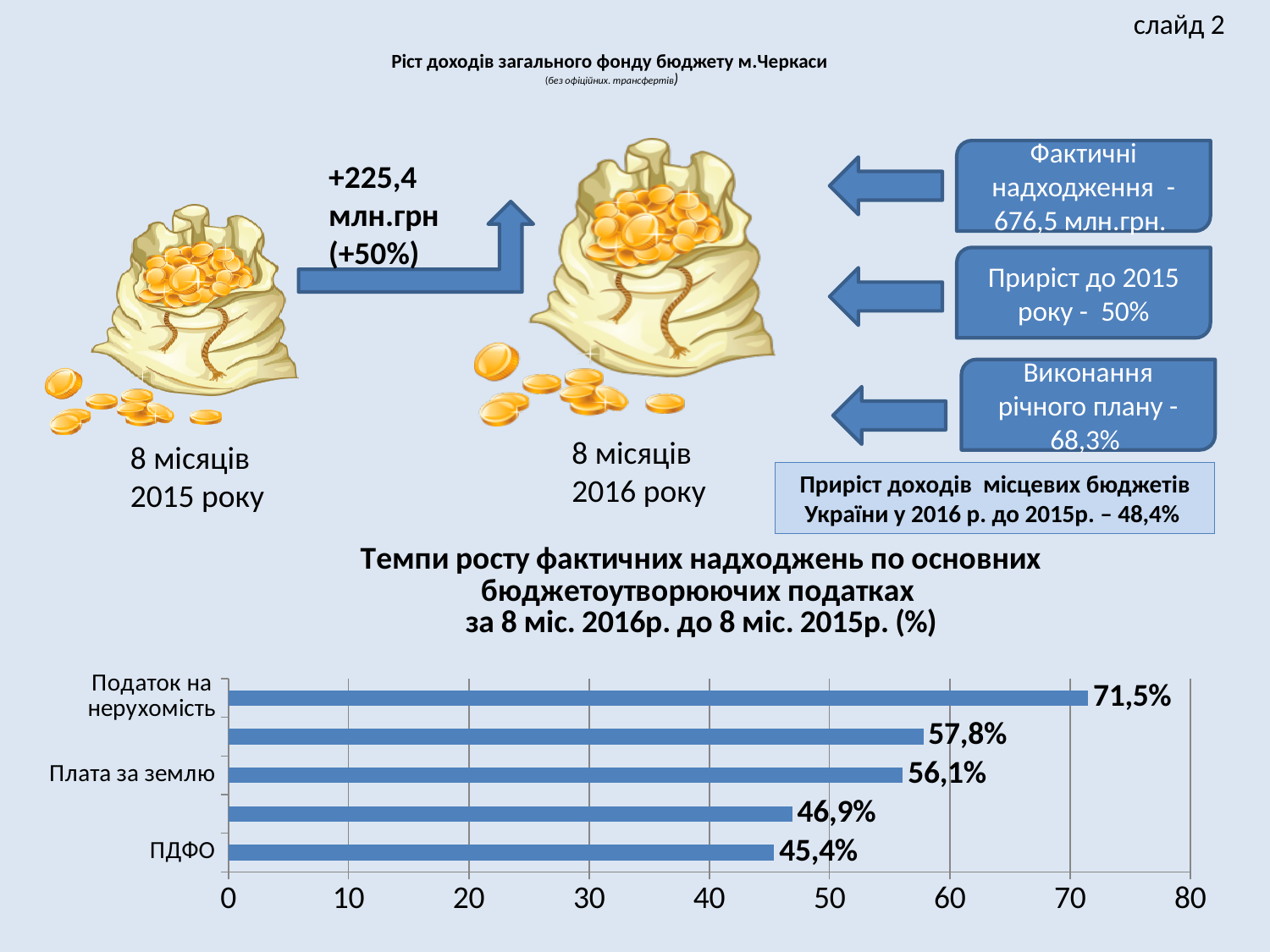
What is the value for Плата за землю in the bar chart? 56,1% Which category has the lowest value in the bar chart? ПДФО Is the value for Податок на нерухомість greater or less than 70? greater By how many percentage points does Податок на нерухомість exceed ПДФО in the bar chart? 26,1 How many bars are plotted in the bar chart? 5 What is the maximum value shown on the horizontal axis of the bar chart? 80 What is the value for Податок на нерухомість in the bar chart? 71,5% Which is larger in the bar chart: Плата за землю or ПДФО? Плата за землю What is the value for ПДФО in the bar chart? 45,4% Which category has the highest value in the bar chart? Податок на нерухомість What is the difference between the values for Плата за землю and ПДФО in the bar chart? 10,7 What kind of chart is shown at the bottom of the slide? bar chart